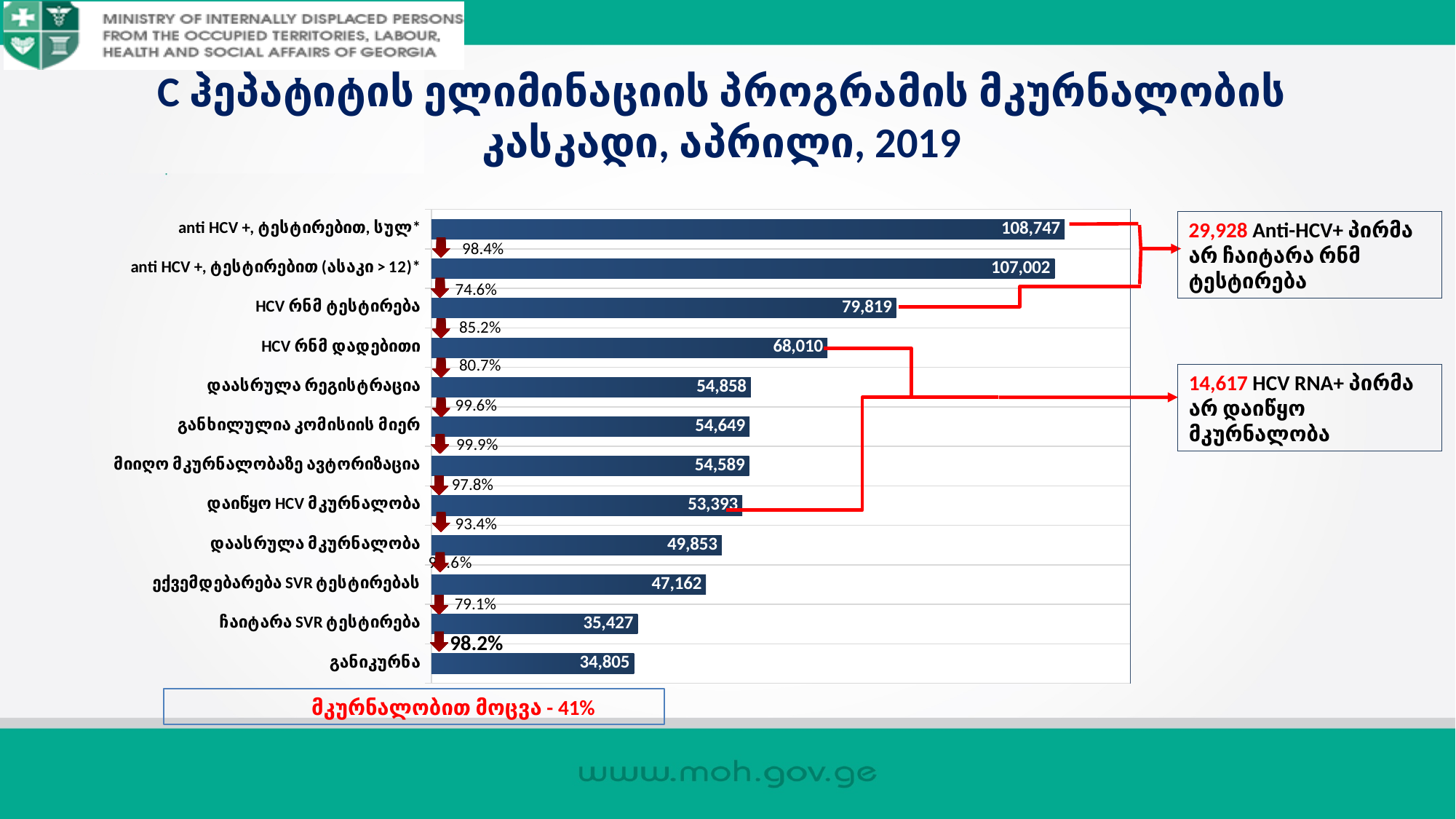
What kind of chart is shown on the slide? bar chart What is the value for "HCV რნმ ტესტირება"? 79,819 Which category has the lowest value? განიკურნა Which category has the highest value? anti HCV +, ტესტირებით, სულ* What is the value for "anti HCV +, ტესტირებით, სულ*"? 108,747 What percentage is shown between "HCV რნმ ტესტირება" and "HCV რნმ დადებითი"? 85.2% Do the bar values rise or fall going from the top of the chart to the bottom? fall What is the value for "განიკურნა"? 34,805 What is the value for "დაიწყო HCV მკურნალობა"? 53,393 How many categories (bars) does the chart show? 12 What is the difference between "HCV რნმ ტესტირება" and "HCV რნმ დადებითი"? 11,809 Which is larger: "დაასრულა მკურნალობა" or "ექვემდებარება SVR ტესტირებას"? დაასრულა მკურნალობა